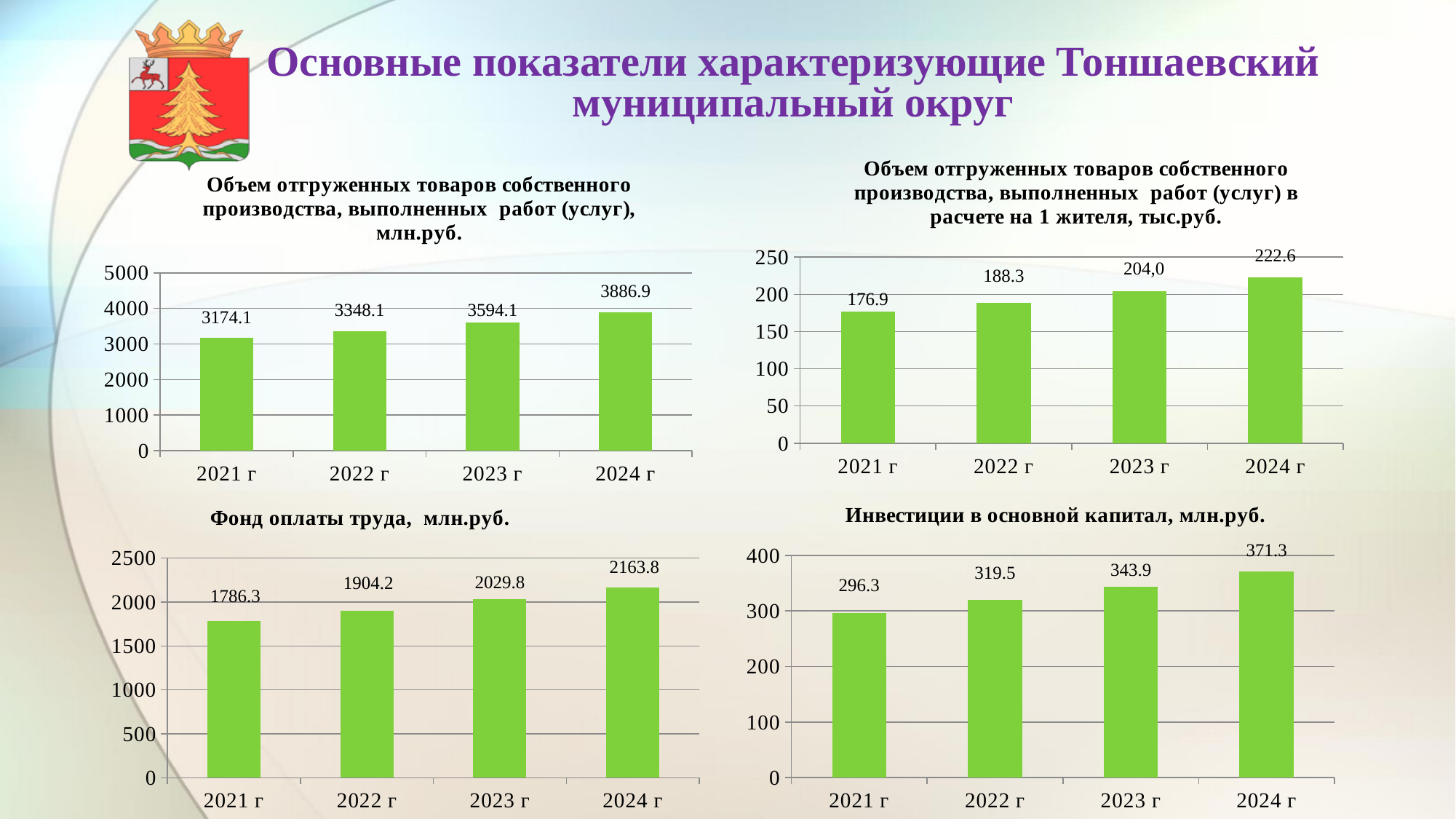
In the bottom-left chart (Фонд оплаты труда, млн.руб.), do the values rise or fall from 2021 г to 2024 г? rise How many bars does the bottom-right chart (Инвестиции в основной капитал, млн.руб.) show? 4 In the bottom-right chart (Инвестиции в основной капитал, млн.руб.), what is the value for 2023 г? 343.9 In the top-right chart (в расчете на 1 жителя, тыс.руб.), which year has the highest value? 2024 г In the bottom-left chart (Фонд оплаты труда, млн.руб.), what is the difference between the 2024 г and 2021 г values? 377.5 In the top-right chart (в расчете на 1 жителя, тыс.руб.), what is the value for 2022 г? 188.3 In the top-left chart (Объем отгруженных товаров ... млн.руб.), which year has the lowest value? 2021 г In the top-left chart (Объем отгруженных товаров ... млн.руб.), what is the difference between the 2024 г and 2021 г values? 712.8 In the top-right chart (в расчете на 1 жителя, тыс.руб.), is the value for 2023 г greater or less than 200? greater In the bottom-left chart (Фонд оплаты труда, млн.руб.), what is the value for 2021 г? 1786.3 In the bottom-right chart (Инвестиции в основной капитал, млн.руб.), which is larger, the value for 2022 г or 2024 г? 2024 г In the top-left chart (Объем отгруженных товаров ... млн.руб.), what is the value for 2024 г? 3886.9